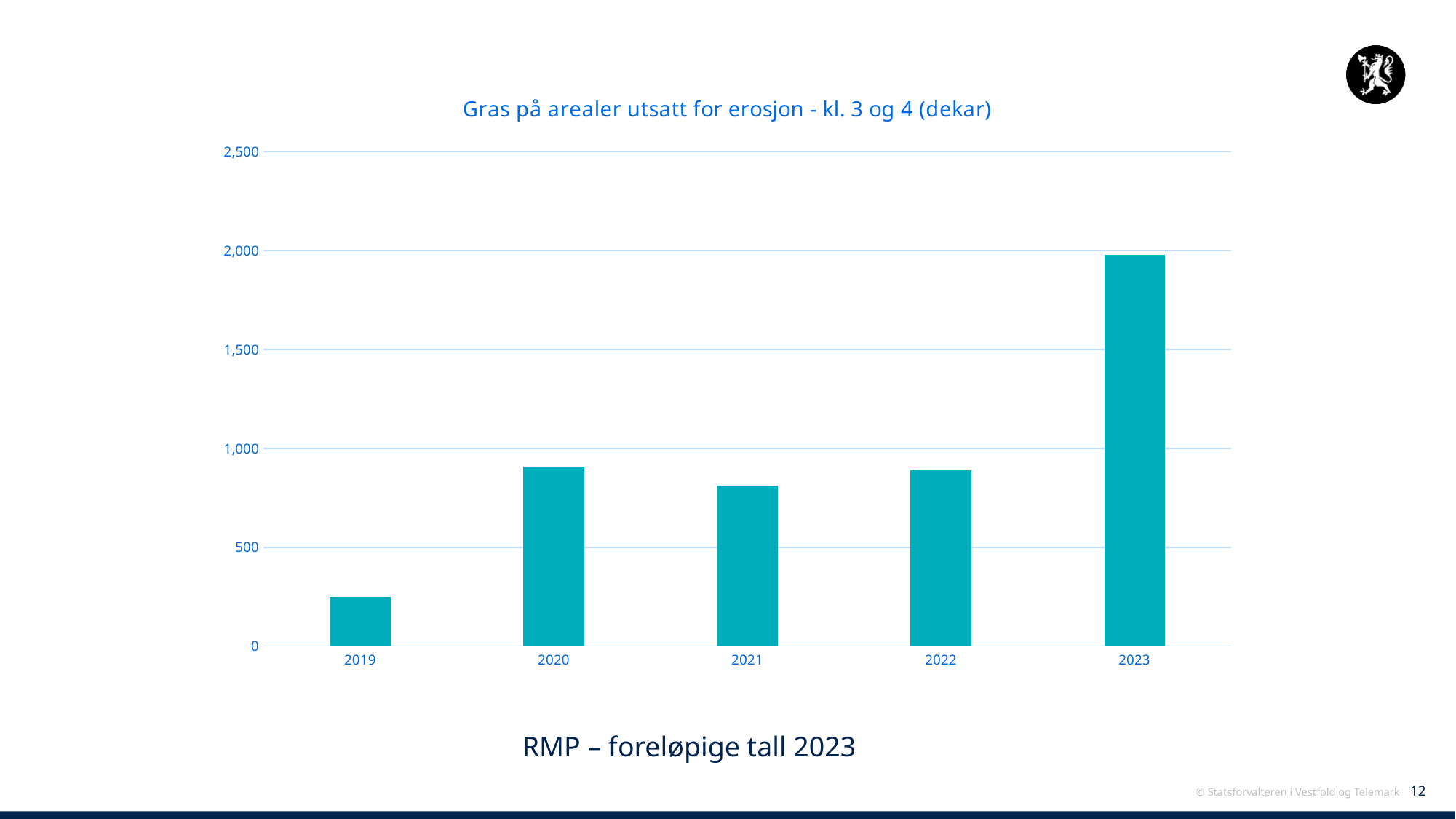
What is the title of the chart? Gras på arealer utsatt for erosjon - kl. 3 og 4 (dekar) Is the value for 2023 greater or less than 1,500? greater Which is larger, the value for 2019 or the value for 2023? 2023 How many years are shown on the x axis of the chart? 5 Is the value for 2019 greater or less than 500? less Is the value for 2020 greater or less than 1,000? less Which year has the lowest value in the chart? 2019 What kind of chart is shown on the slide? bar chart Which year has the highest value in the chart? 2023 Which is larger, the value for 2020 or the value for 2021? 2020